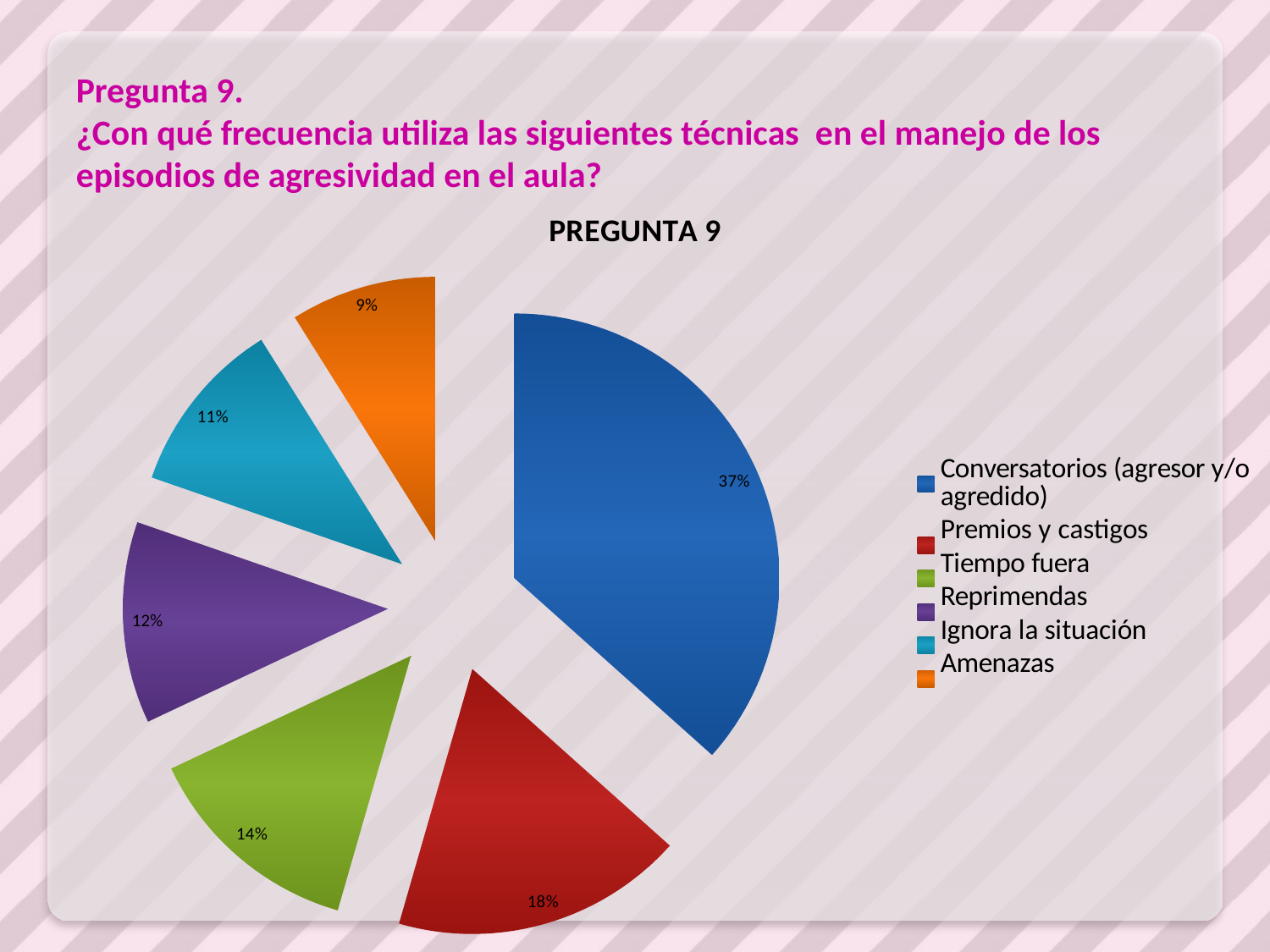
What percentage is shown for Amenazas? 9% Which is larger, the slice for Tiempo fuera or the slice for Ignora la situación? Tiempo fuera What type of chart is shown on the slide? Pie chart What percentage is shown for Premios y castigos? 18% Which category has the smallest slice of the pie? Amenazas What is the title of the chart? PREGUNTA 9 What percentage is shown for Tiempo fuera? 14% What percentage of the pie does Conversatorios (agresor y/o agredido) represent? 37% How many categories does the pie chart have? 6 Which category has the largest slice of the pie? Conversatorios (agresor y/o agredido) What is the difference in percentage points between Conversatorios (agresor y/o agredido) and Premios y castigos? 19 What percentage is shown for Reprimendas? 12%